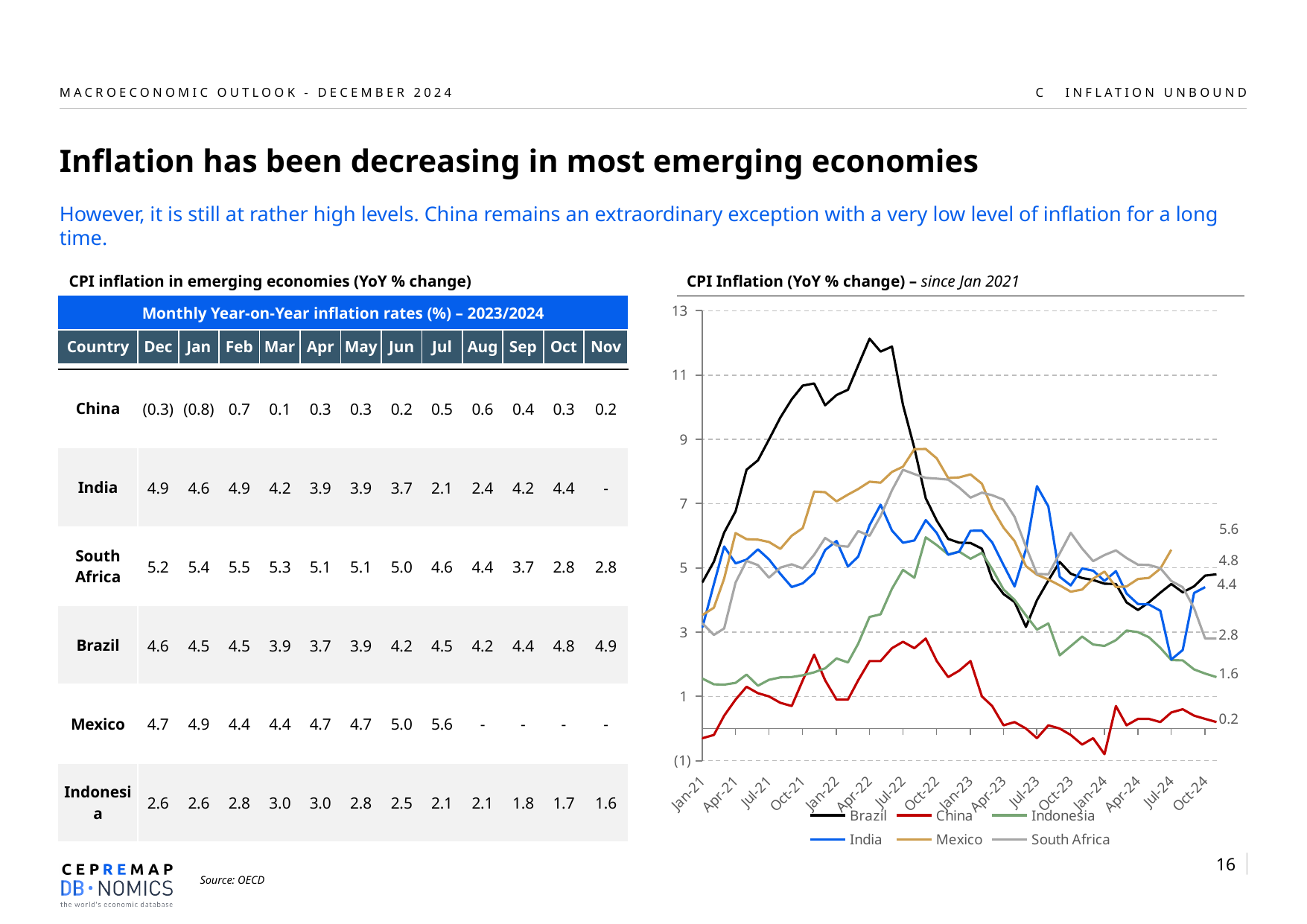
What kind of chart is the 'CPI Inflation (YoY % change) – since Jan 2021' chart? line chart In the 'CPI Inflation (YoY % change)' chart, what is the last labelled value for Mexico? 5.6 In the 'CPI Inflation (YoY % change)' chart, which country's line reaches the highest value over the period shown? Brazil In the 'CPI Inflation (YoY % change)' chart, does Brazil's line rise or fall between Apr-22 and Jul-23? fall In the 'CPI Inflation (YoY % change)' chart, which is larger at the end of the series: the labelled value for Brazil (4.8) or for South Africa (2.8)? Brazil In the 'CPI Inflation (YoY % change)' chart, is Brazil's peak value in 2022 greater or less than 11? greater How many series does the legend of the 'CPI Inflation (YoY % change)' chart list? 6 In the 'CPI Inflation (YoY % change)' chart, what is the last labelled value for China? 0.2 In the 'CPI Inflation (YoY % change)' chart, which country's line is the lowest for most of the period? China In the 'CPI Inflation (YoY % change)' chart, is China's value in Jul-22 greater or less than 3? less In the 'CPI Inflation (YoY % change)' chart, what colour is the line for India? blue In the 'CPI Inflation (YoY % change)' chart, what is the last labelled value for Indonesia? 1.6